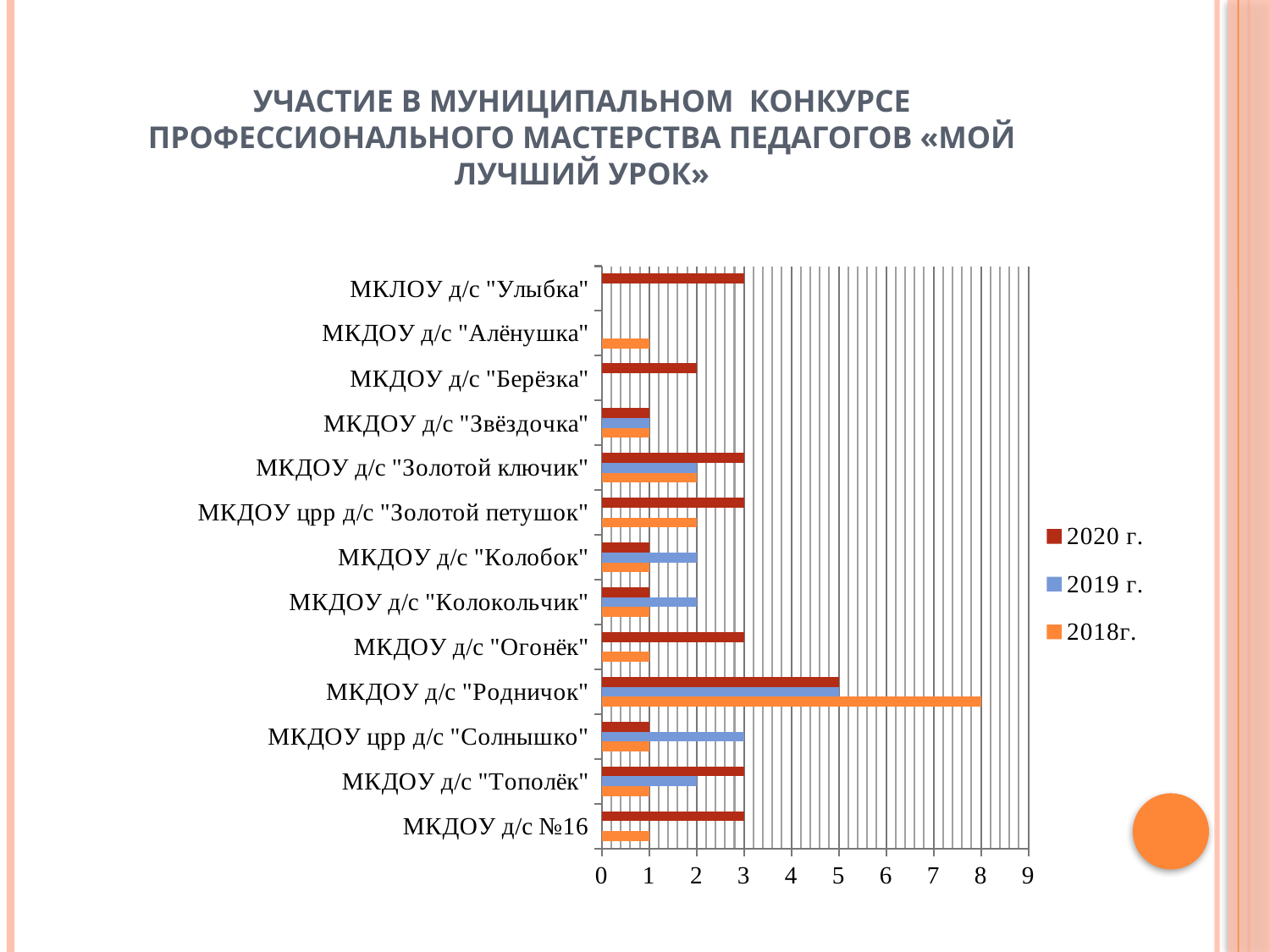
What is the value for МКДОУ црр д/с "Солнышко" in the 2019 г. series? 3 What is the value for МКДОУ д/с "Родничок" in the 2020 г. series? 5 Is the 2018г. value for МКДОУ д/с "Родничок" greater or less than 6? greater What kind of chart is shown on the slide? bar chart Which institution has the highest value in the 2018г. series? МКДОУ д/с "Родничок" Which series is shown in orange in the legend? 2018г. What is the value for МКДОУ д/с "Родничок" in the 2018г. series? 8 Which is larger for МКДОУ д/с "Тополёк": the 2020 г. value or the 2018г. value? 2020 г. How many categories (institutions) are shown on the chart? 13 What is the difference between the 2018г. and 2020 г. values for МКДОУ д/с "Родничок"? 3 What is the value for МКДОУ д/с "Берёзка" in the 2020 г. series? 2 How many series does the legend list? 3